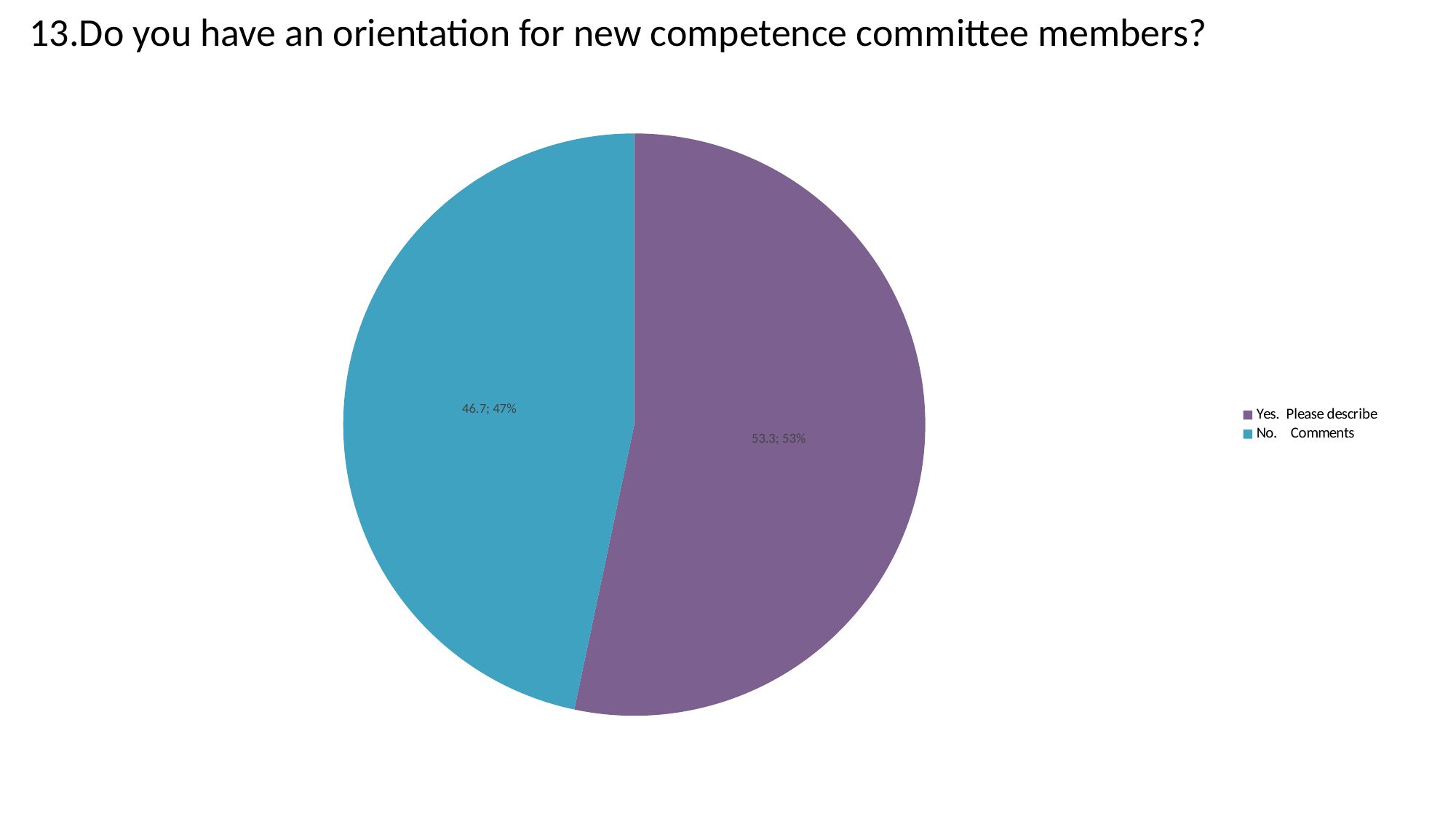
What percentage share of the pie does the "Yes. Please describe" slice represent? 53% What is the value shown for the "Yes. Please describe" slice? 53.3 Which slice is the largest in the pie chart? Yes. Please describe What colour is the "No. Comments" slice? blue Which is larger, the "Yes. Please describe" slice or the "No. Comments" slice? Yes. Please describe What is the difference between the values for "Yes. Please describe" and "No. Comments"? 6.6 How many slices does the pie chart have? 2 How many entries does the legend list? 2 What kind of chart is shown on the slide? pie chart What percentage share of the pie does the "No. Comments" slice represent? 47% What is the value shown for the "No. Comments" slice? 46.7 Which slice is the smallest in the pie chart? No. Comments